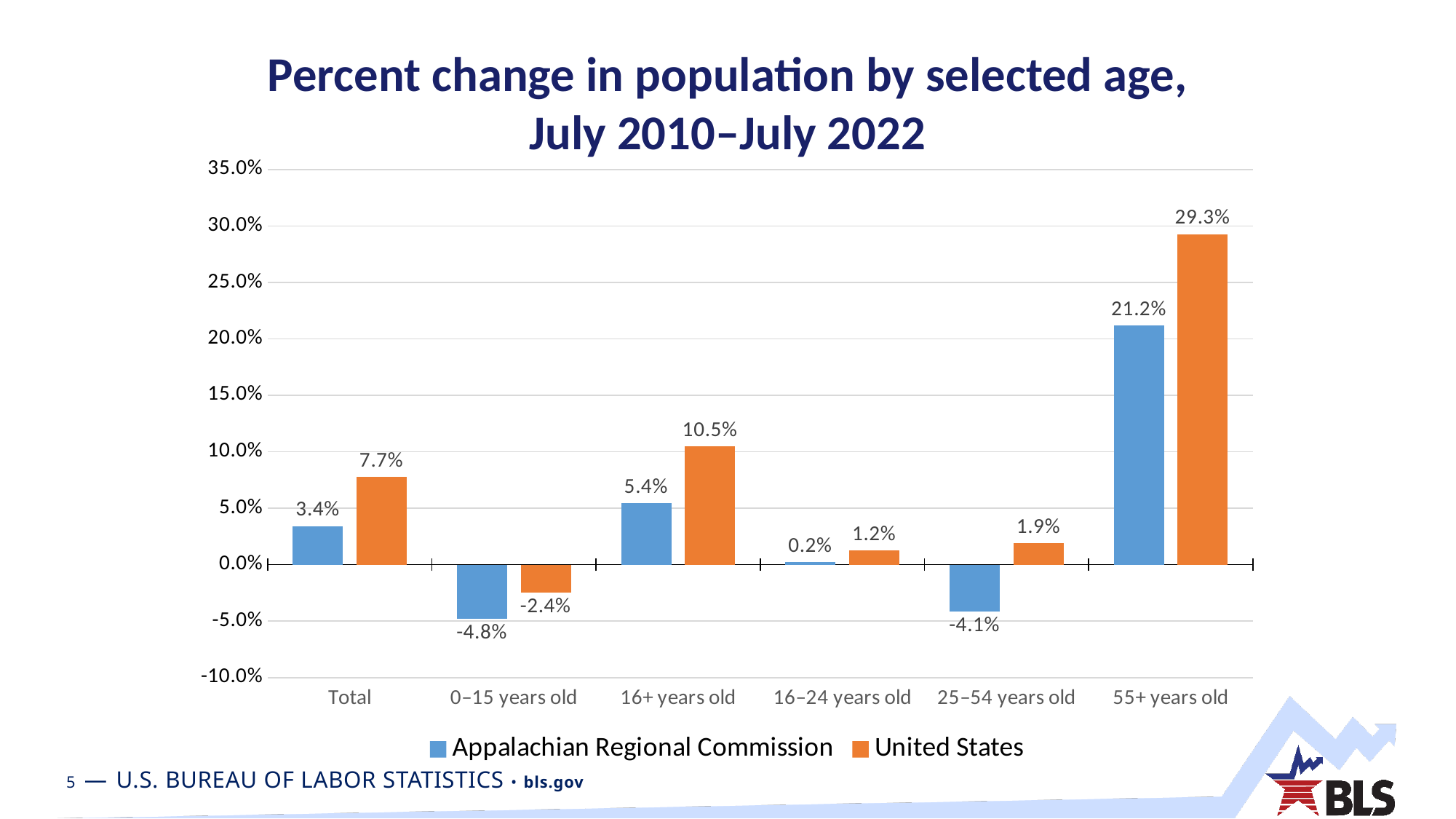
Which age category has the lowest percent change for the United States? 0–15 years old Which age category has the highest percent change for the Appalachian Regional Commission? 55+ years old How many series does the legend list? 2 What is the percent change in population for the 0–15 years old group in the Appalachian Regional Commission? -4.8% Which colour represents the United States series in the chart? Orange How many age categories are shown on the x axis? 6 What is the percent change for the 25–54 years old group in the Appalachian Regional Commission? -4.1% What kind of chart is shown on the slide? Bar chart What is the Total percent change in population for the United States? 7.7% What is the difference between the United States and Appalachian Regional Commission values for the 55+ years old group? 8.1% For the 16+ years old group, which is larger: the Appalachian Regional Commission value or the United States value? United States What is the percent change in population for the 55+ years old group in the United States? 29.3%